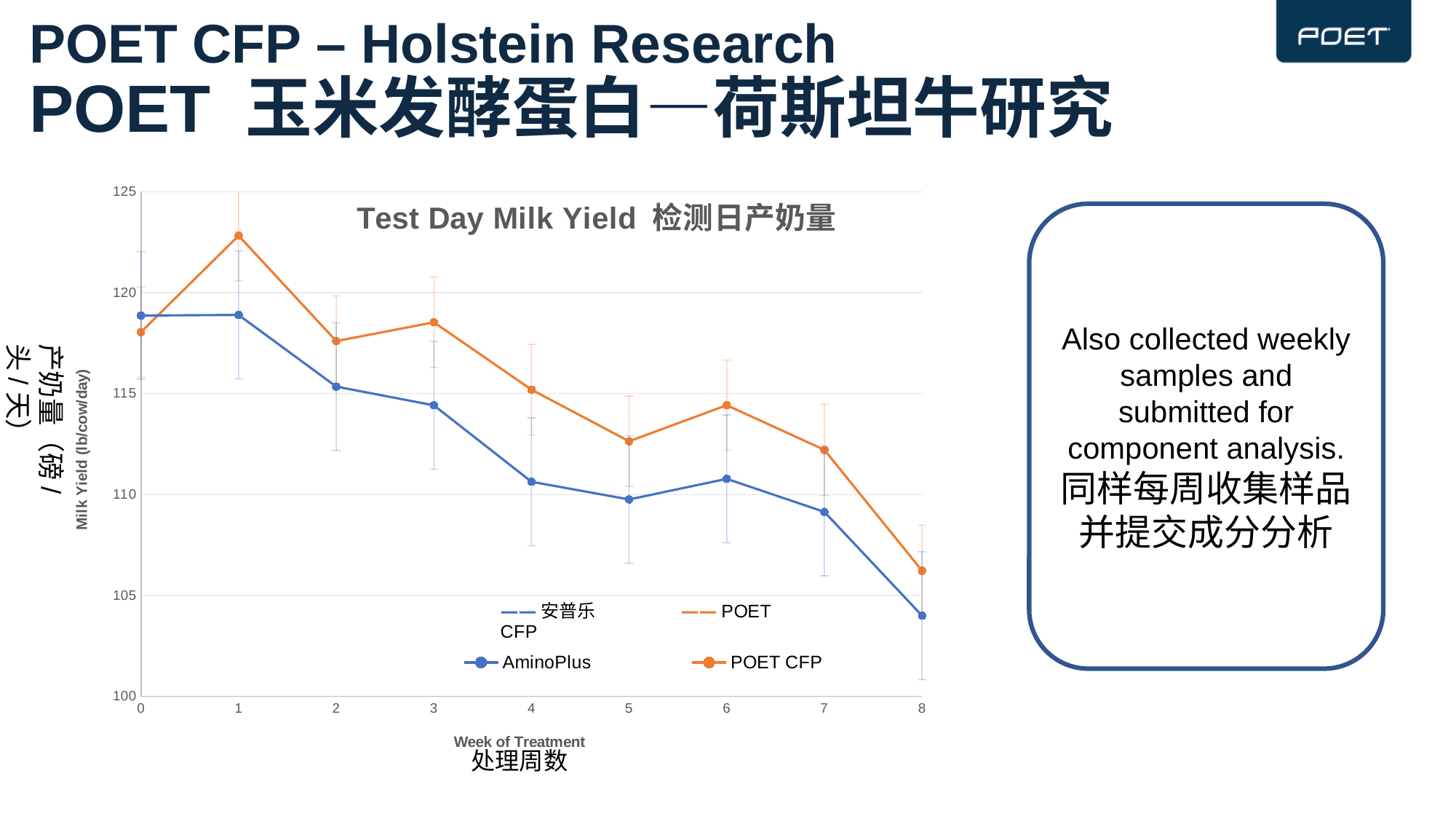
Is the AminoPlus value at week 0 greater or less than 120? less Is the POET CFP value at week 5 greater or less than 115? less How many weeks (x-axis points) are plotted for each series? 9 At week 1, which series has the higher milk yield, AminoPlus or POET CFP? POET CFP At which week does the AminoPlus series reach its lowest value? 8 What kind of chart is shown on the slide? line chart Is the POET CFP value at week 1 greater or less than 120? greater What is the title of the chart? Test Day Milk Yield 检测日产奶量 Overall, do the milk yield values rise or fall from week 1 to week 8? fall What is the label of the x axis of the chart? Week of Treatment At which week does the POET CFP series reach its highest value? 1